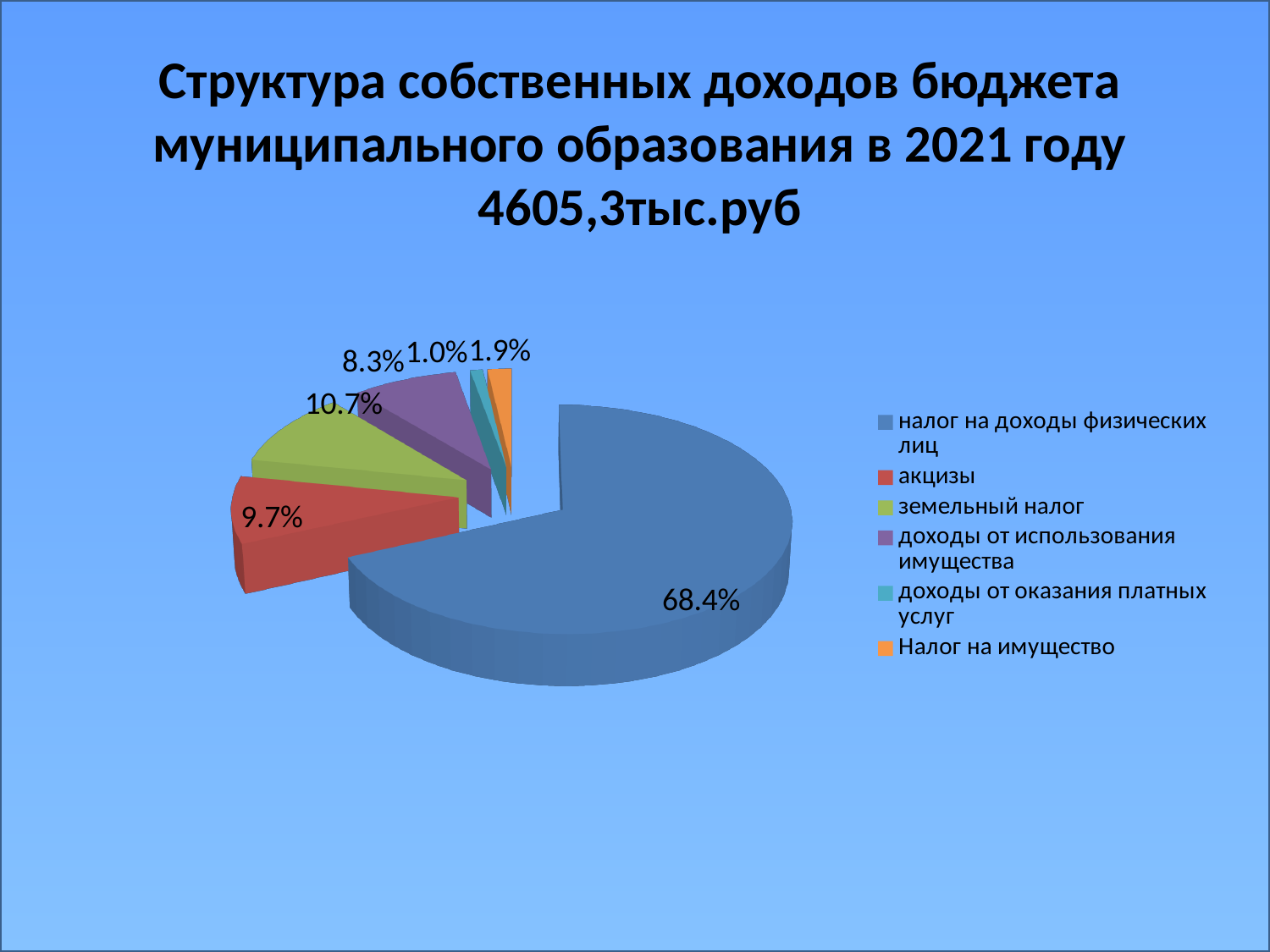
What kind of chart is shown on the slide? pie chart Which category has the largest slice of the pie? налог на доходы физических лиц What is the difference between the shares of земельный налог and акцизы? 1.0% What is the value shown for доходы от использования имущества? 8.3% What share of the pie does налог на доходы физических лиц have? 68.4% What is the value shown for акцизы? 9.7% Which is larger, the share for акцизы or the share for доходы от использования имущества? акцизы What is the value shown for земельный налог? 10.7% What colour is the slice for земельный налог? green What is the value shown for Налог на имущество? 1.9% Which category has the smallest slice of the pie? доходы от оказания платных услуг How many categories does the legend list? 6